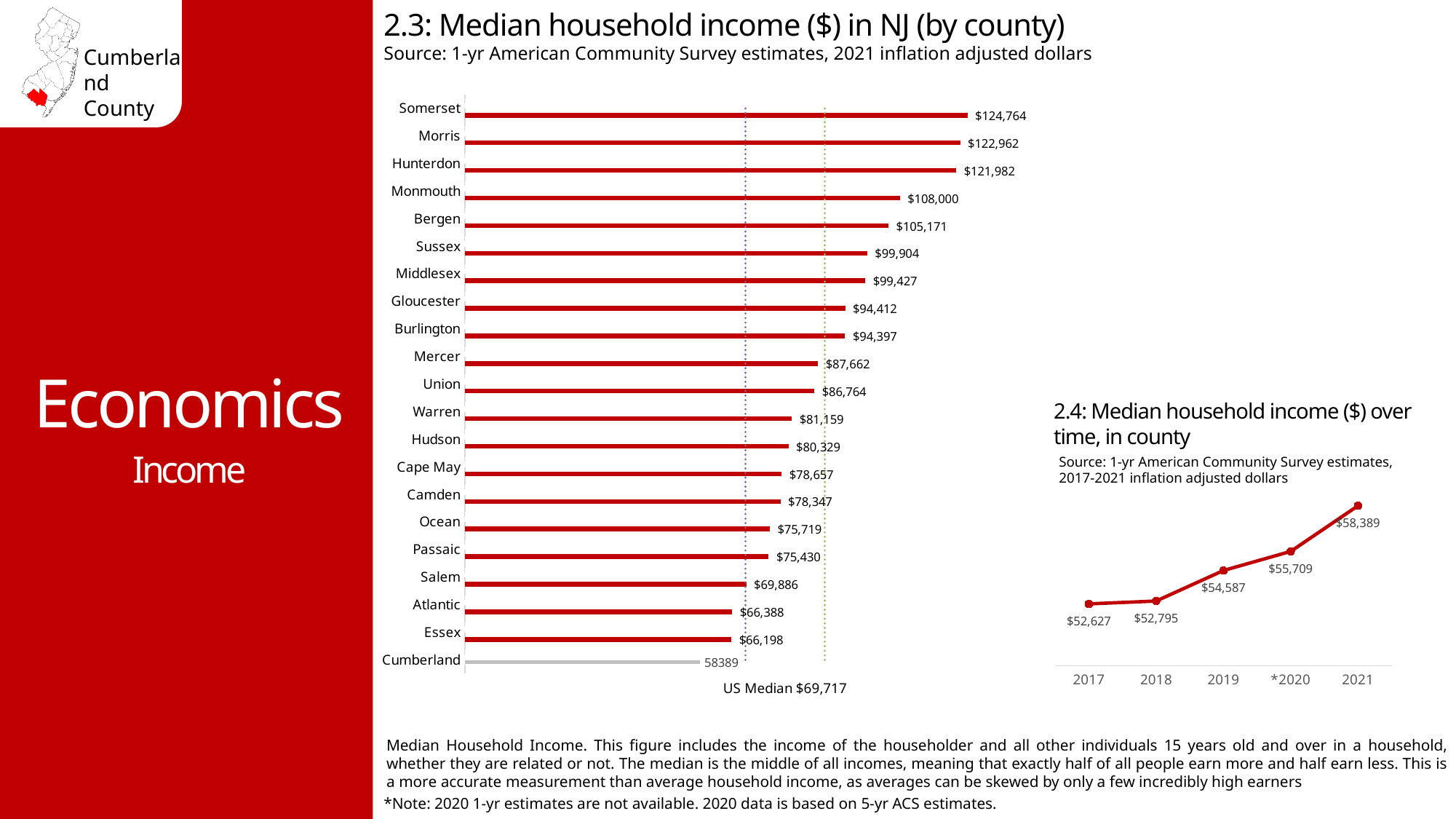
In the chart '2.4: Median household income ($) over time, in county', what is the difference between the 2021 and 2017 values? $5,762 In the chart '2.4: Median household income ($) over time, in county', does the median household income rise or fall from 2017 to 2021? Rise In the chart '2.4: Median household income ($) over time, in county', what is the median household income for 2019? $54,587 In the chart '2.3: Median household income ($) in NJ (by county)', which has a higher median household income, Monmouth or Bergen? Monmouth How many counties are shown in the chart '2.3: Median household income ($) in NJ (by county)'? 21 In the chart '2.3: Median household income ($) in NJ (by county)', which county has the lowest median household income? Cumberland In the chart '2.3: Median household income ($) in NJ (by county)', what is the difference between Somerset's and Cumberland's median household income? $66,375 In the chart '2.3: Median household income ($) in NJ (by county)', which county has the highest median household income? Somerset What kind of chart is '2.3: Median household income ($) in NJ (by county)'? Bar chart In the chart '2.3: Median household income ($) in NJ (by county)', what is the median household income for Somerset? $124,764 What kind of chart is '2.4: Median household income ($) over time, in county'? Line chart In the chart '2.3: Median household income ($) in NJ (by county)', what is the median household income for Cumberland? 58389